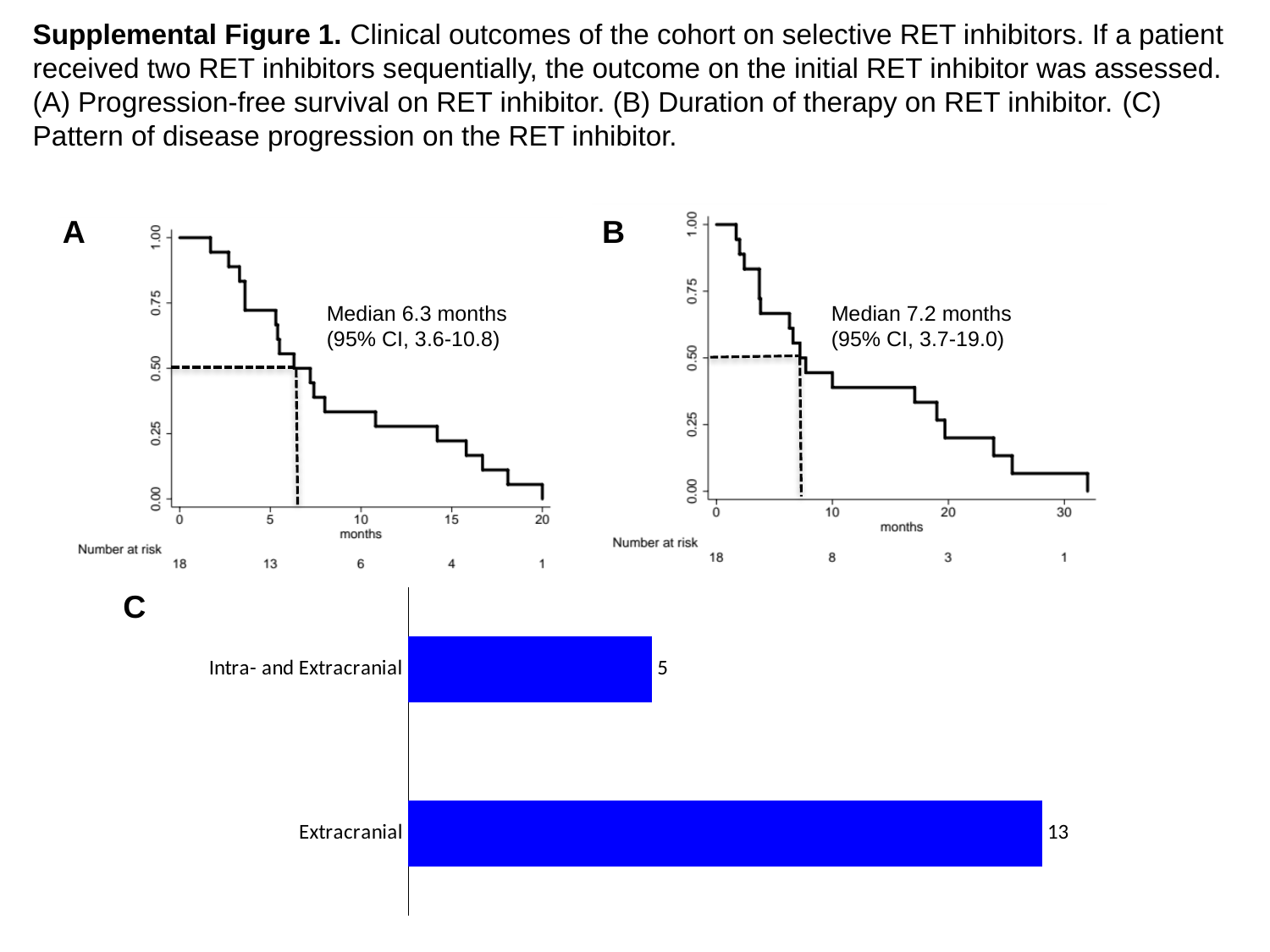
In chart C (Pattern of disease progression), what is the value for Extracranial? 13 In chart B (Duration of therapy), what is the number at risk at 20 months? 3 In chart B (Duration of therapy), what is the median reported on the chart? 7.2 months In chart C (Pattern of disease progression), what is the value for Intra- and Extracranial? 5 In chart A (Progression-free survival), does the survival curve rise or fall as months increase? fall In chart A (Progression-free survival), what is the median reported on the chart? 6.3 months Which chart reports the larger median, chart A (Progression-free survival) or chart B (Duration of therapy)? chart B In chart A (Progression-free survival), what is the number at risk at 10 months? 6 In chart C (Pattern of disease progression), which category has the highest value? Extracranial What kind of chart is chart C (Pattern of disease progression)? bar chart In chart C (Pattern of disease progression), what is the difference between the Extracranial and Intra- and Extracranial values? 8 In chart C (Pattern of disease progression), how many categories are shown? 2